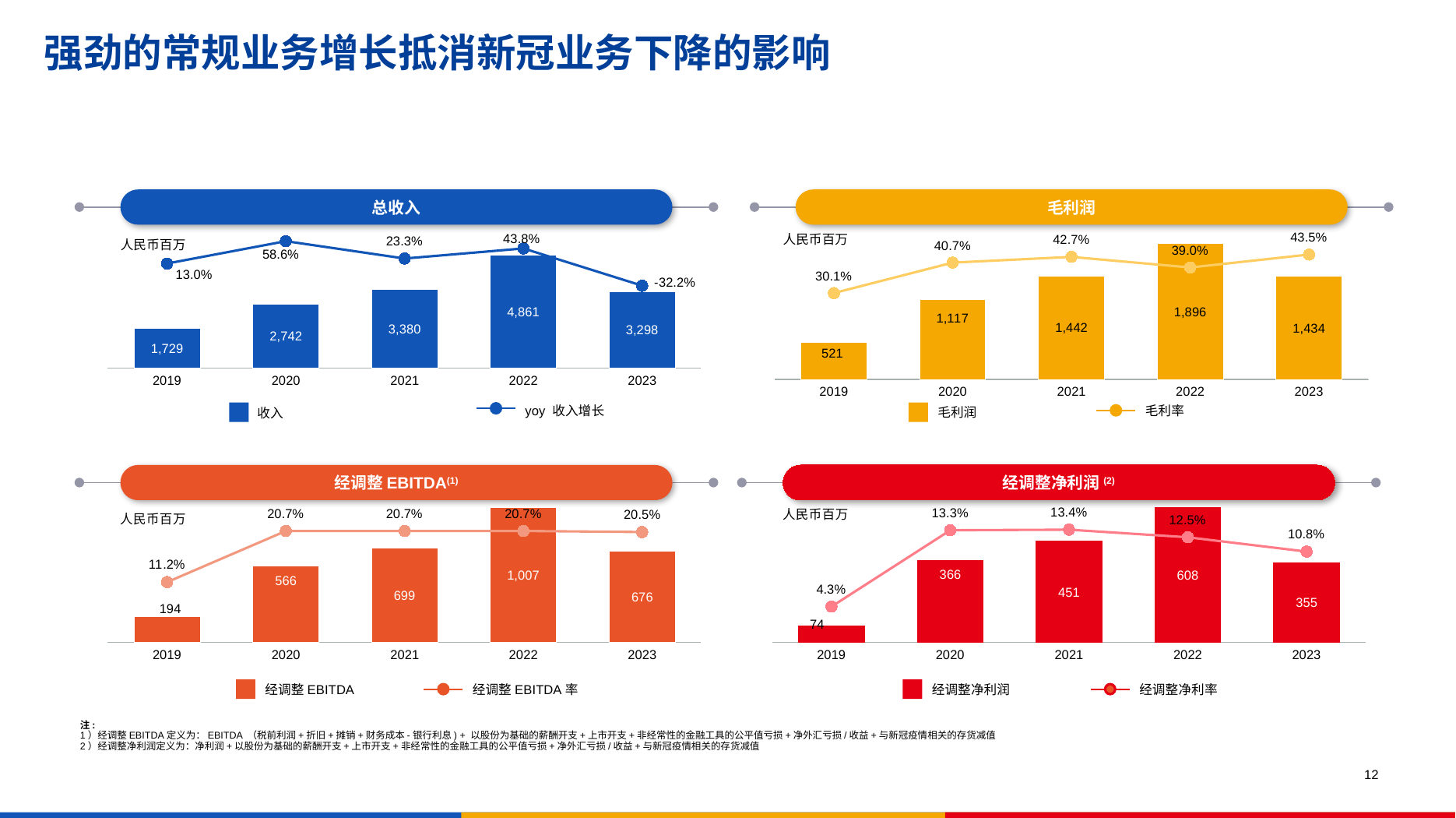
In the 毛利润 chart, which year has the lowest 毛利润? 2019 In the 总收入 chart, what is the 收入 value for 2022? 4,861 In the 经调整净利润 chart, how many series does the legend list? 2 In the 毛利润 chart, what is the 毛利率 for 2021? 42.7% In the 经调整净利润 chart, which is larger, the 经调整净利润 for 2020 or for 2023? 2020 What kind of chart is the 总收入 chart? Combined bar and line chart In the 总收入 chart, what is the yoy 收入增长 value for 2023? -32.2% In the 经调整净利润 chart, what is the 经调整净利率 for 2020? 13.3% In the 总收入 chart, which year has the highest 收入? 2022 In the 毛利润 chart, what is the difference in 毛利润 between 2022 and 2023? 462 In the 经调整 EBITDA chart, what is the 经调整 EBITDA value for 2021? 699 In the 经调整 EBITDA chart, how many years are shown on the x axis? 5